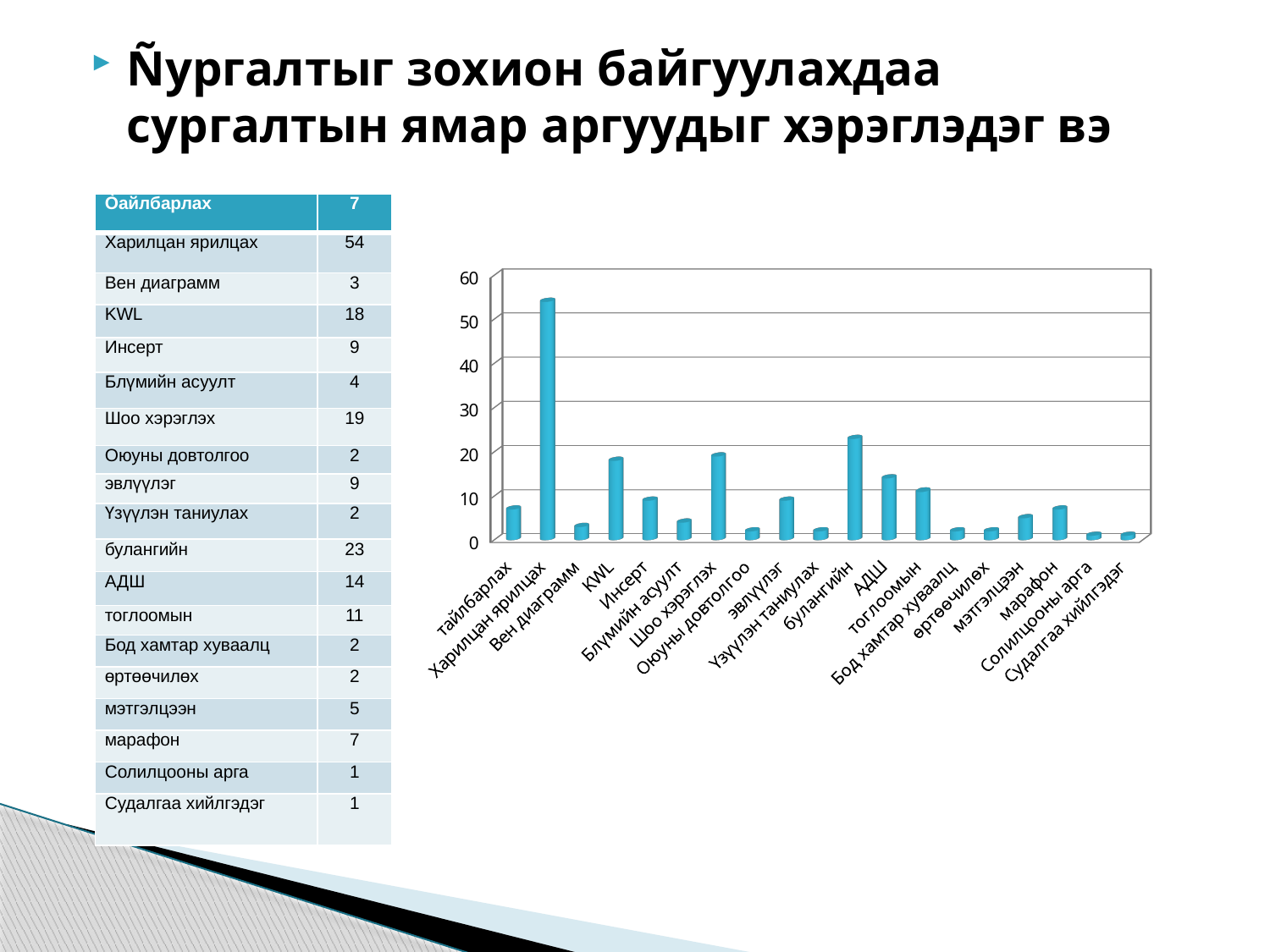
How many categories are plotted on the chart? 19 Is the value for Инсерт greater or less than 10? less What is the value for АДШ? 14 Which is larger, the value for булангийн or the value for АДШ? булангийн Which category has the highest value on the chart? Харилцан ярилцах Is the value for Харилцан ярилцах greater or less than 50? greater Is the value for булангийн greater or less than 20? greater What is the value for KWL? 18 What is the value for Харилцан ярилцах? 54 What is the value for булангийн? 23 What is the difference between the values for Харилцан ярилцах and булангийн? 31 What type of chart is shown on the slide? bar chart